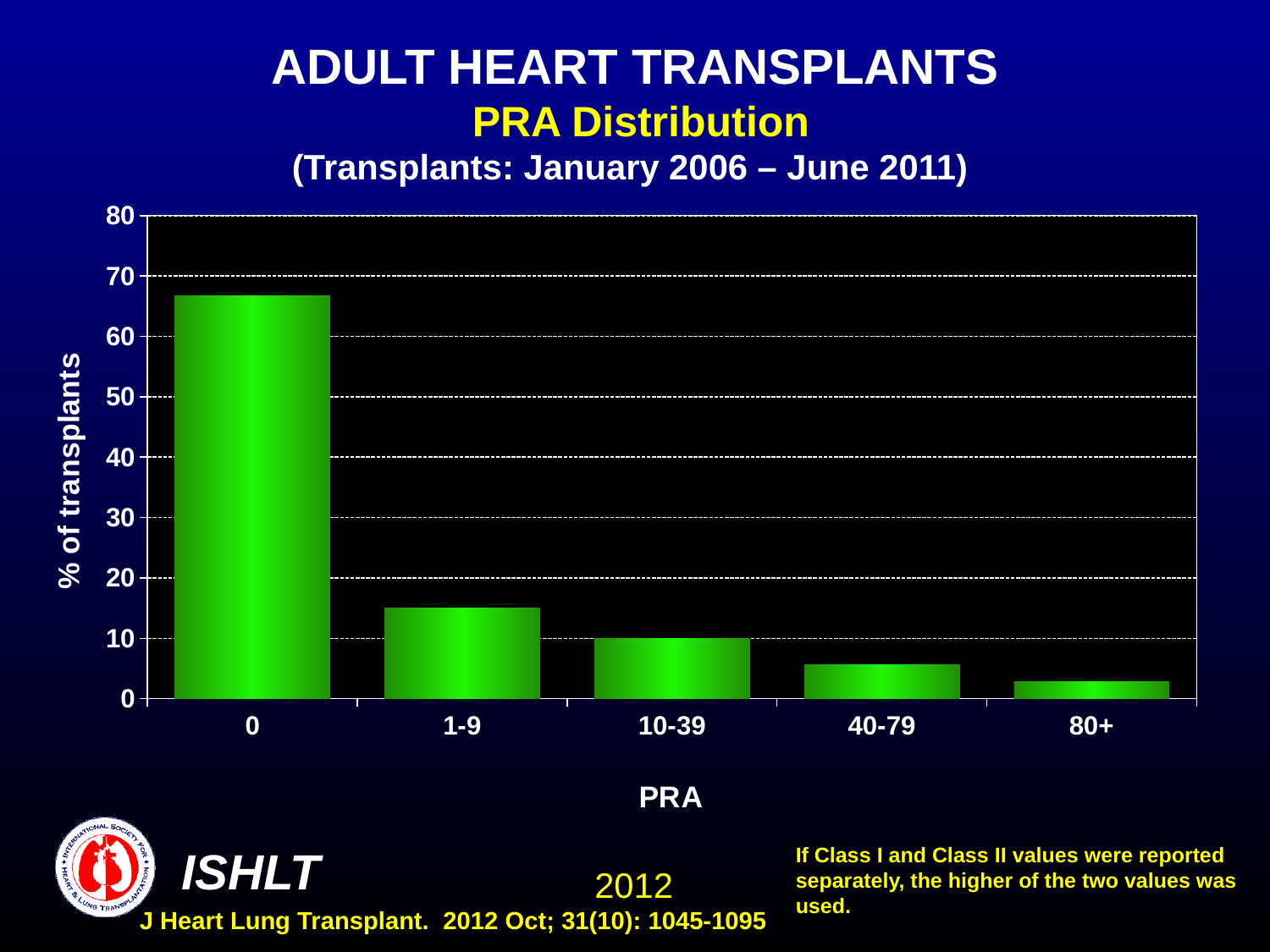
Which PRA category has the highest % of transplants? 0 Do the values rise or fall as PRA increases along the x axis? fall Is the value for PRA 40-79 greater or less than 10? less Is the value for PRA 0 greater or less than 70? less Is the value for PRA 1-9 greater or less than 10? greater How many PRA categories are shown on the x axis? 5 Which has a larger % of transplants, PRA 1-9 or PRA 40-79? 1-9 What kind of chart is shown on the slide? bar chart What is the label of the y axis? % of transplants Which PRA category has the lowest % of transplants? 80+